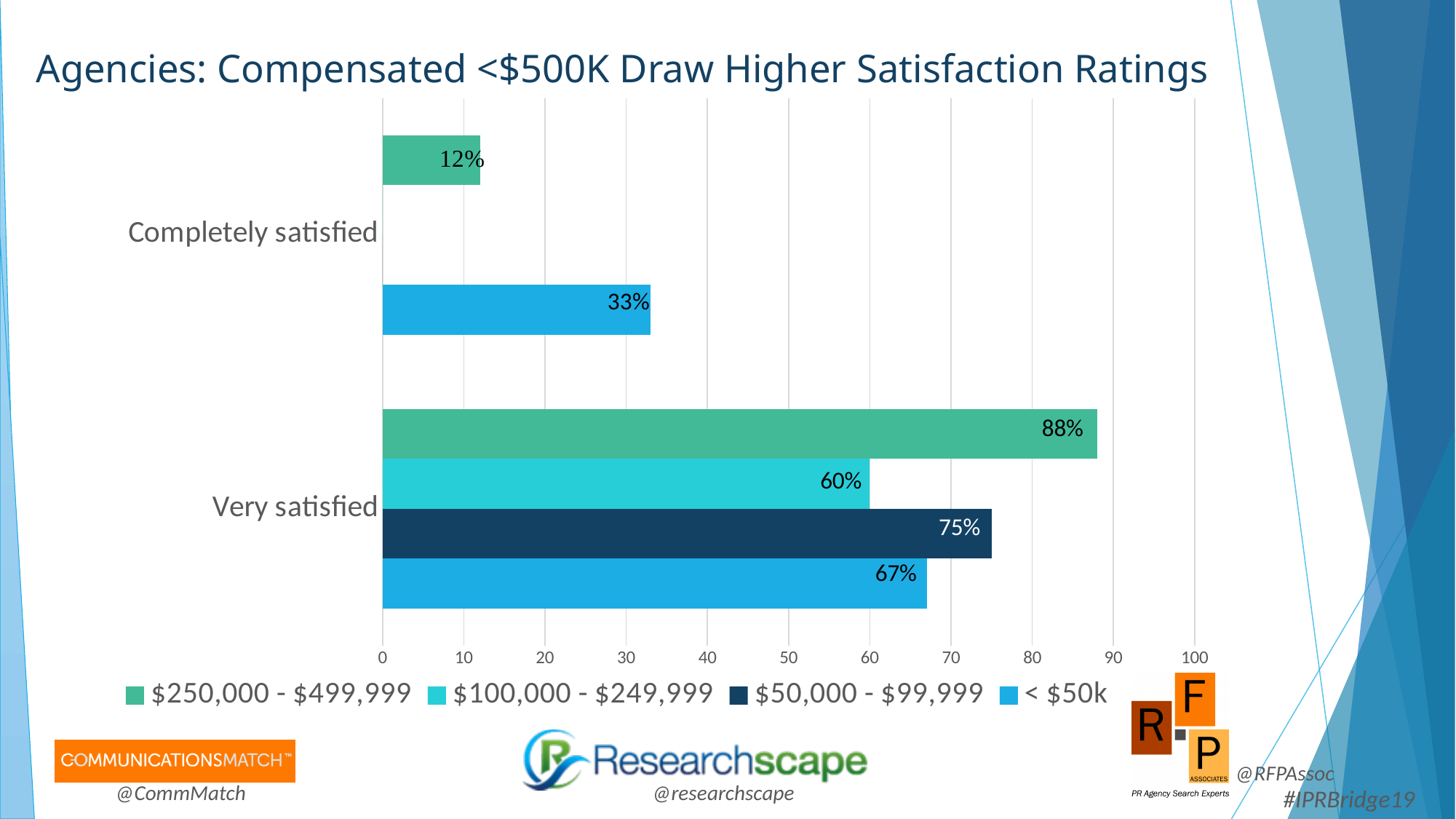
How many series does the legend list? 4 How many satisfaction categories are shown on the vertical axis? 2 What is the value for the $250,000 - $499,999 series in the Very satisfied category? 88% In the Completely satisfied category, which is larger: the < $50k value or the $250,000 - $499,999 value? < $50k What is the title of the chart? Agencies: Compensated <$500K Draw Higher Satisfaction Ratings Which series has the lowest value in the Very satisfied category? $100,000 - $249,999 What is the value for the $50,000 - $99,999 series in the Very satisfied category? 75% Which series has the highest value in the Very satisfied category? $250,000 - $499,999 What is the value for the $100,000 - $249,999 series in the Very satisfied category? 60% What is the difference between the $250,000 - $499,999 and < $50k values in the Very satisfied category? 21% What kind of chart is shown on the slide? Bar chart What is the value for the < $50k series in the Completely satisfied category? 33%